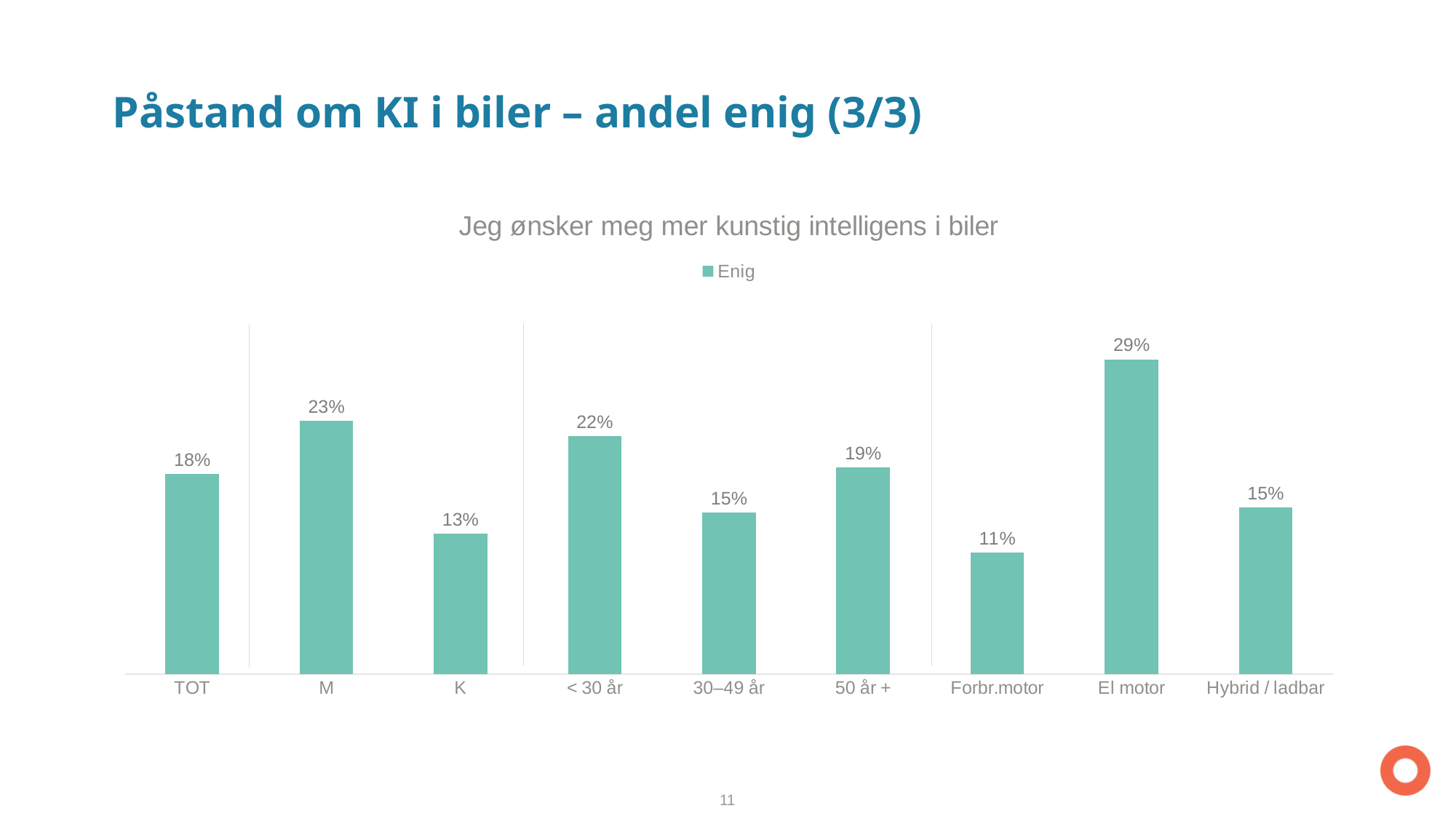
Which is larger, the value for < 30 år or the value for 30–49 år? < 30 år What kind of chart is shown? bar chart What is the value for K? 13% What is the difference between the values for M and K? 10% What is the value for 50 år +? 19% What is the difference between the values for El motor and Forbr.motor? 18% What is the value for TOT? 18% What is the value for El motor? 29% Which category has the highest value? El motor What is the title of the chart? Jeg ønsker meg mer kunstig intelligens i biler Which category has the lowest value? Forbr.motor How many categories are shown on the x axis? 9